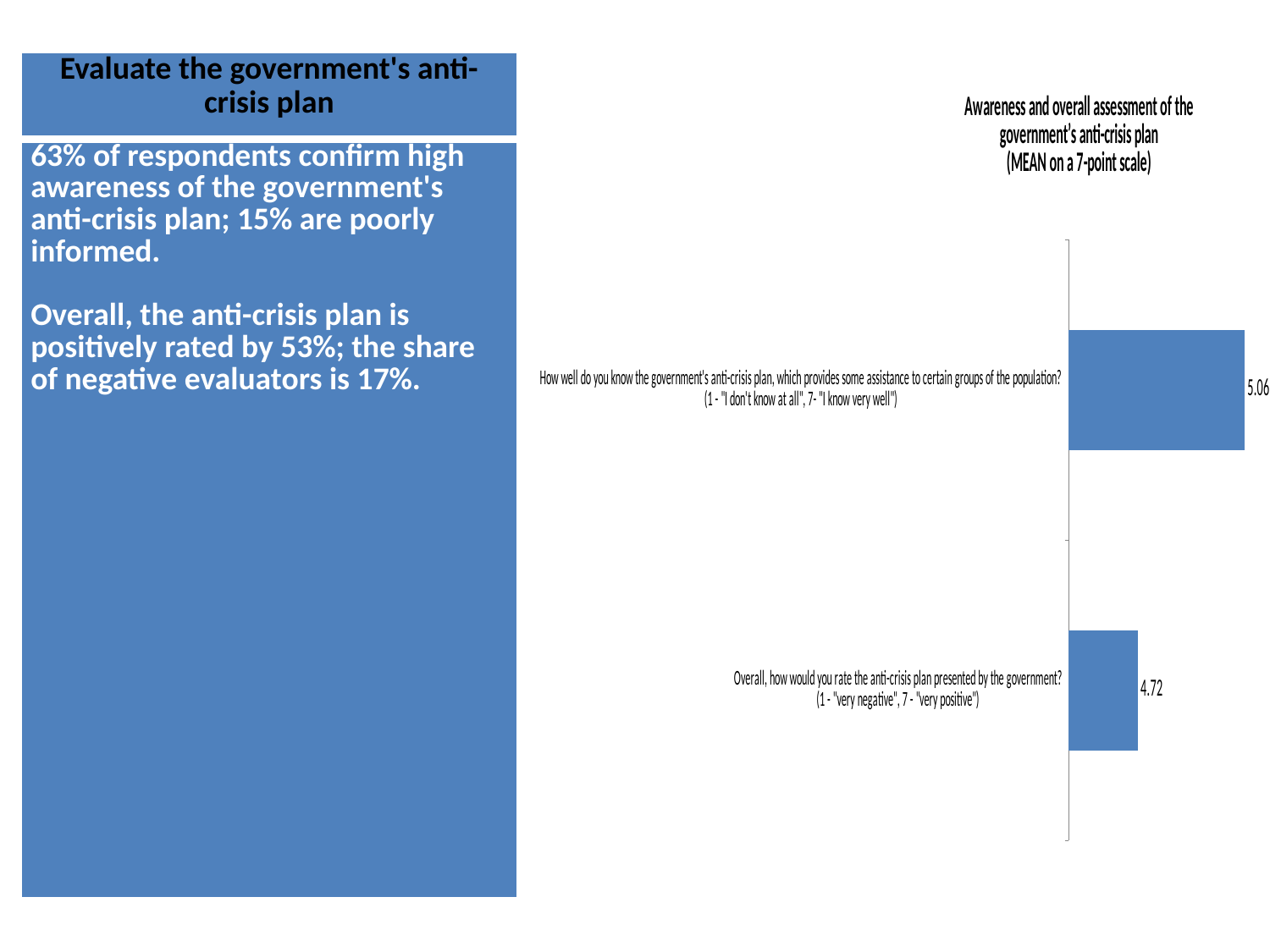
Is the mean for awareness of the plan larger or smaller than the mean for the overall rating of the plan? larger What kind of chart is shown on the slide? bar chart Which category has the higher mean value? How well do you know the government's anti-crisis plan Which category has the lower mean value? Overall, how would you rate the anti-crisis plan presented by the government What is the mean value for 'How well do you know the government's anti-crisis plan'? 5.06 On what scale are the mean values in the chart measured? 7-point scale What is the mean value for 'Overall, how would you rate the anti-crisis plan presented by the government'? 4.72 How many categories are plotted in the chart? 2 What is the title of the chart? Awareness and overall assessment of the government's anti-crisis plan (MEAN on a 7-point scale) What is the difference between the awareness mean (5.06) and the overall rating mean (4.72)? 0.34